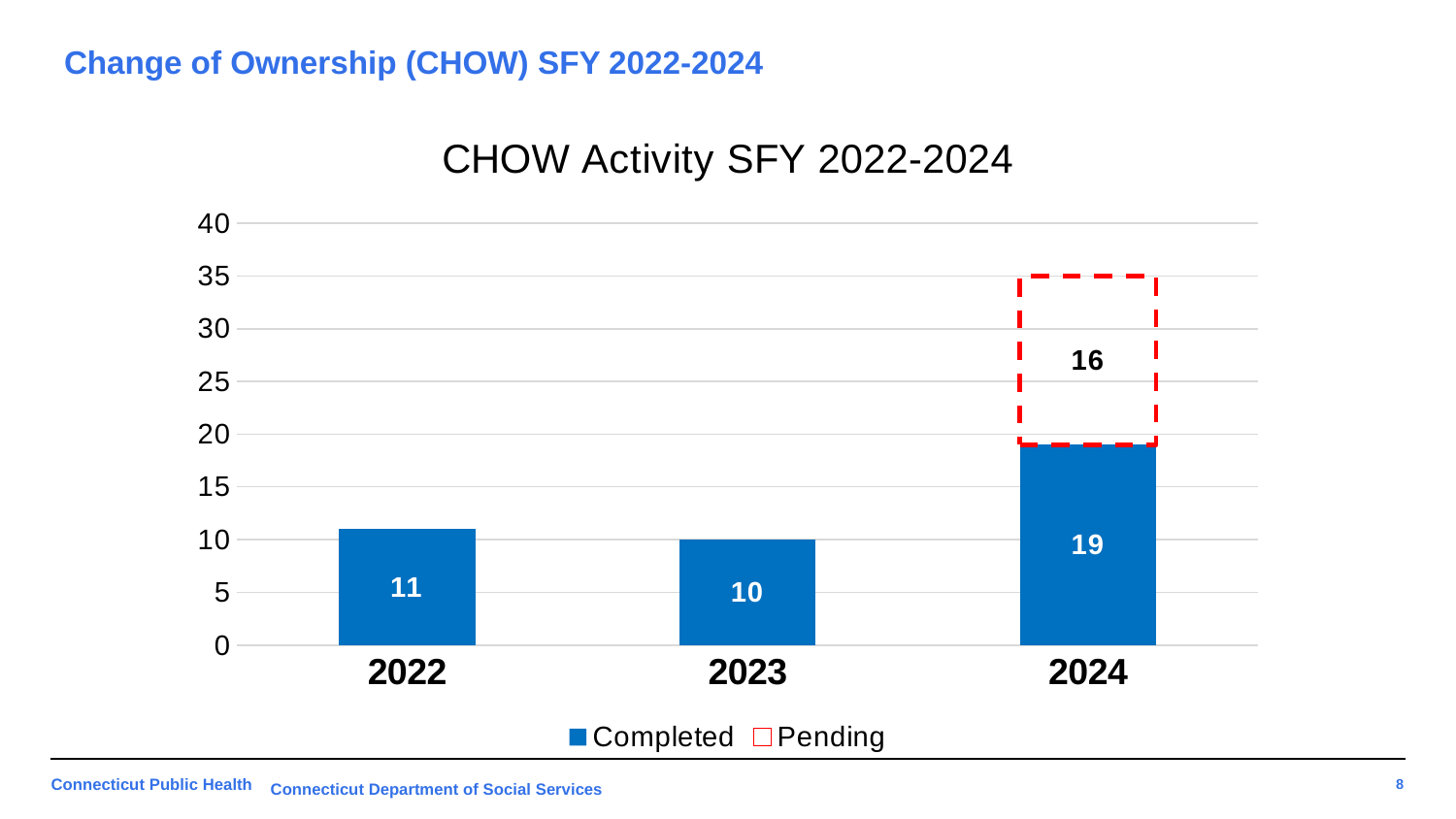
What is the Completed value for 2022? 11 What is the difference between the Completed values for 2024 and 2023? 9 Is the Completed value for 2022 greater or less than 10? greater What is the Completed value for 2024? 19 How many years are shown on the x axis? 3 What is the title of the chart? CHOW Activity SFY 2022-2024 Which year has the highest Completed value? 2024 What is the Completed value for 2023? 10 How many series does the legend list? 2 What is the Pending value for 2024? 16 What is the total of the stacked bar for 2024 (Completed plus Pending)? 35 Which year has the lowest Completed value? 2023